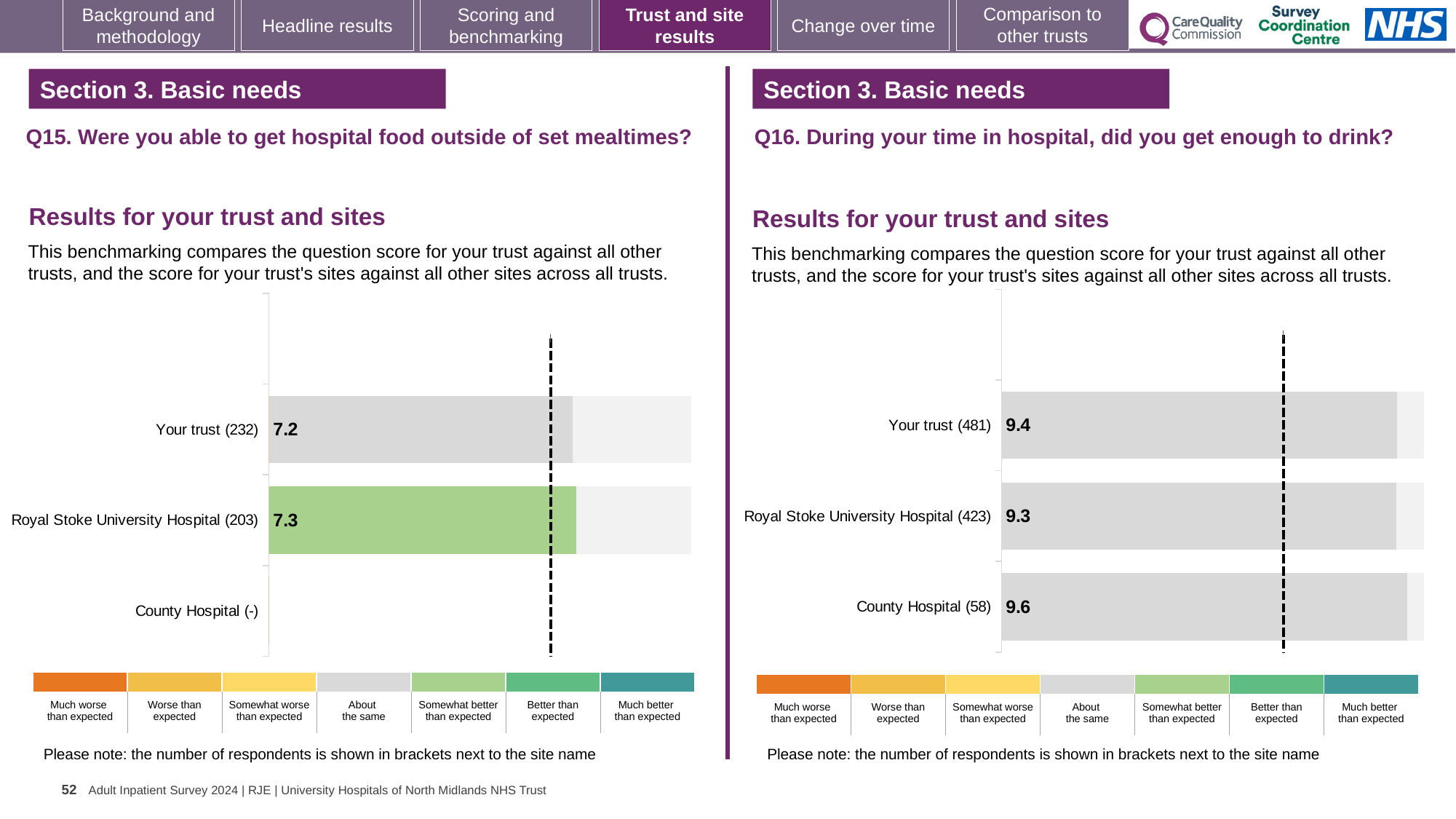
On the Q15 chart (left), what is the difference between the Royal Stoke University Hospital score and the Your trust score? 0.1 On the Q15 chart (left), what is the score for Royal Stoke University Hospital? 7.3 On the Q16 chart (right), what is the difference between the County Hospital score and the Your trust score? 0.2 On the Q16 chart (right), what is the score for County Hospital? 9.6 On the Q15 chart (left), how many respondents are shown in brackets for Royal Stoke University Hospital? 203 On the Q16 chart (right), which is larger: the score for Your trust or the score for Royal Stoke University Hospital? Your trust On the Q16 chart (right), which row has the lowest score? Royal Stoke University Hospital On the Q16 chart (right), what is the score for Your trust? 9.4 On the Q16 chart (right), which site or trust row has the highest score? County Hospital What kind of chart is used on the Q16 chart (right)? Bar chart On the Q15 chart (left), what is the score for Your trust? 7.2 How many rows (trust and sites) are listed on the Q15 chart (left)? 3